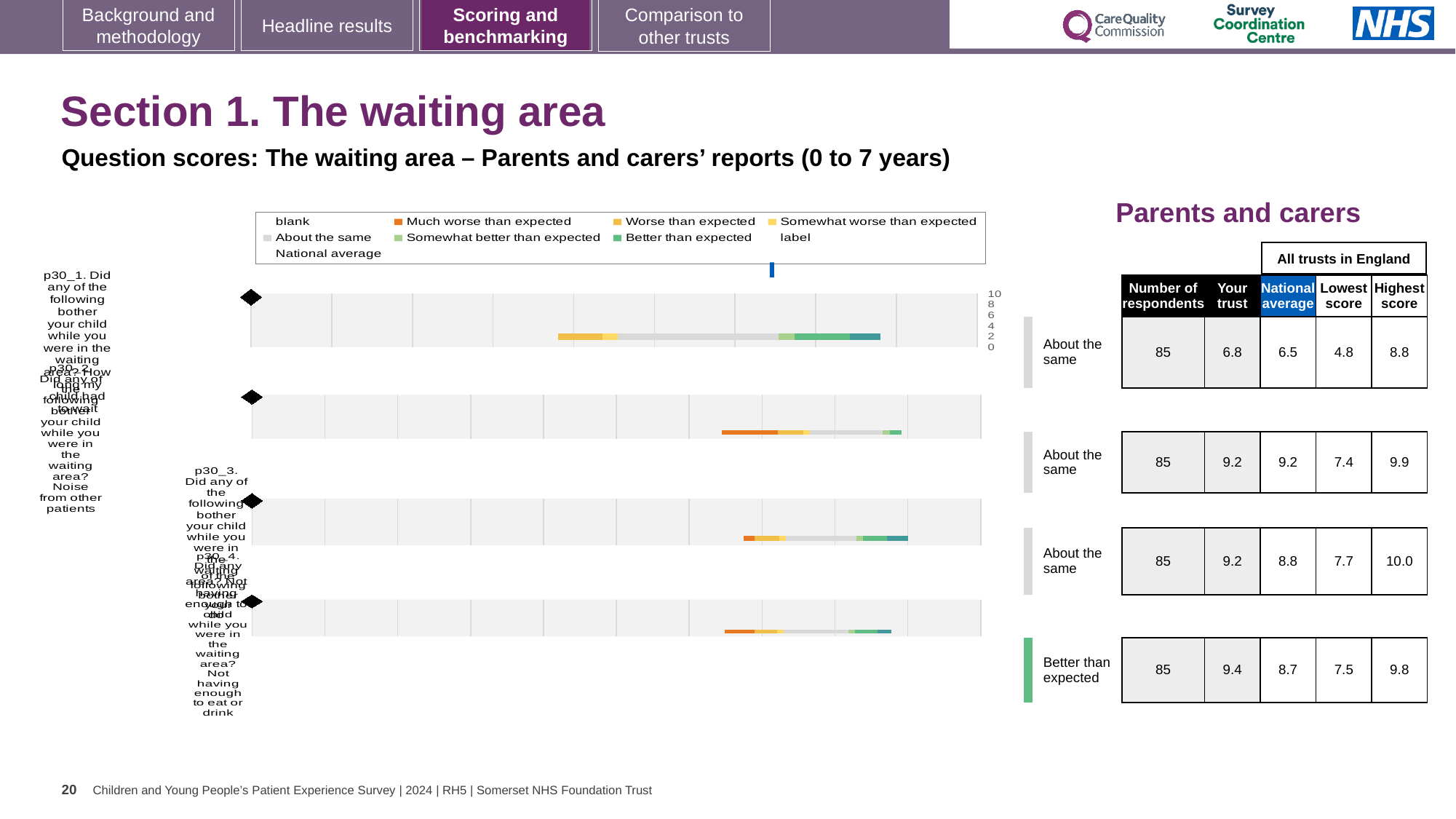
What is the 'Your trust' score for the first question row (p30_1)? 6.8 How many respondents answered the second question row (p30_2)? 85 Which question row is rated 'Better than expected'? p30_4 (fourth row) Which legend entry is shown in orange? Much worse than expected What is the highest score across all trusts in England for the third question row (p30_3)? 10.0 What is the lowest score across all trusts in England for the first question row (p30_1)? 4.8 What is the national average for the fourth question row (p30_4)? 8.7 How many question bars are plotted in the chart? 4 What is the difference between the trust score and the national average for the fourth question row (p30_4)? 0.7 How many entries does the chart legend list? 9 What kind of chart is shown on the slide? bar chart Which question row has the highest 'Your trust' score? p30_4 (fourth row)